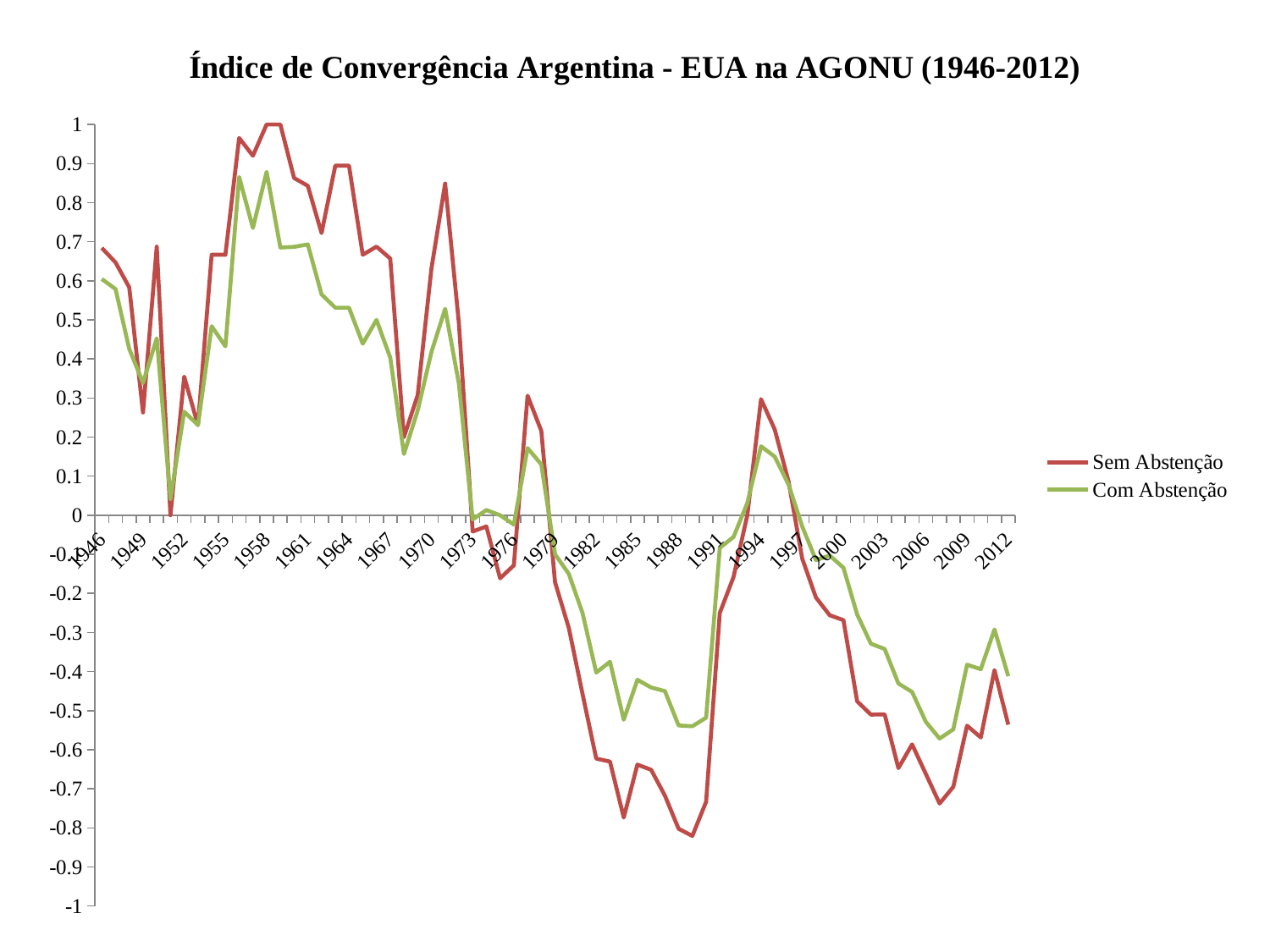
What kind of chart is shown on the slide? line chart Do the values of the Sem Abstenção series rise or fall between 1991 and 1994? rise In 1985, which series has the higher value, Sem Abstenção or Com Abstenção? Com Abstenção In 1958, which series has the higher value, Sem Abstenção or Com Abstenção? Sem Abstenção Is the value for Com Abstenção in 1988 greater or less than -0.5? less Is the value for Com Abstenção in 1964 greater or less than 0.4? greater Is the value for Sem Abstenção in 1946 greater or less than 0.5? greater What is the title of the chart? Índice de Convergência Argentina - EUA na AGONU (1946-2012) Which colour is used for the Sem Abstenção series? red How many series does the legend list? 2